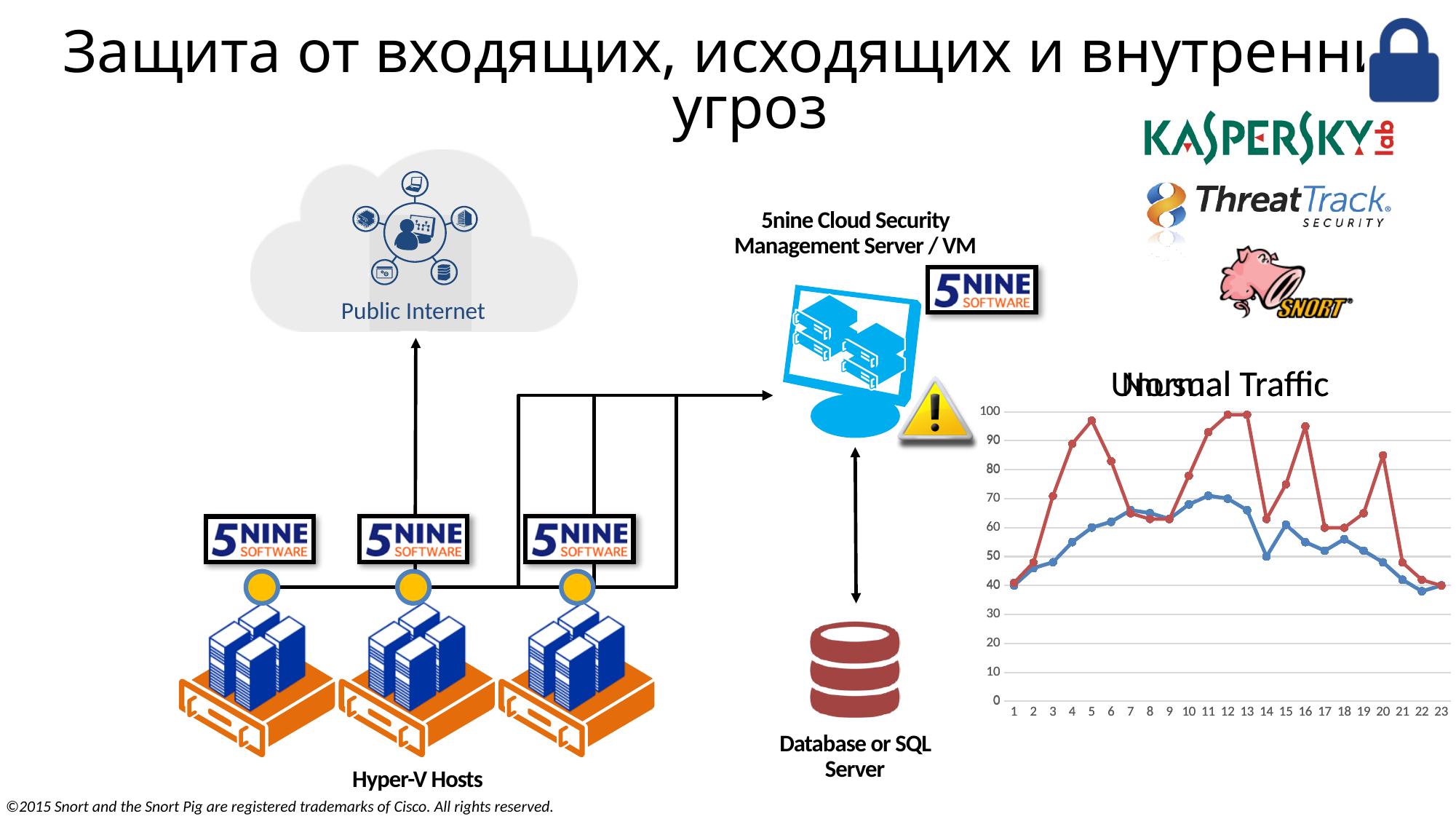
In the line chart, is the value of the red line at x = 20 greater or less than 80? greater What kind of chart is shown on the right side of the slide? line chart In the line chart, is the value of the blue line at x = 11 greater or less than 60? greater How many lines are plotted in the line chart? 2 In the line chart, which line has the higher value at x = 12, the red line or the blue line? the red line How many points are labelled along the x axis of the line chart? 23 In the line chart, is the value of the red line at x = 2 greater or less than 50? less In the line chart, which line has the higher value at x = 16, the red line or the blue line? the red line In the line chart, does the blue line rise or fall from x = 1 to x = 5? rise What is the highest value shown on the y axis of the line chart? 100